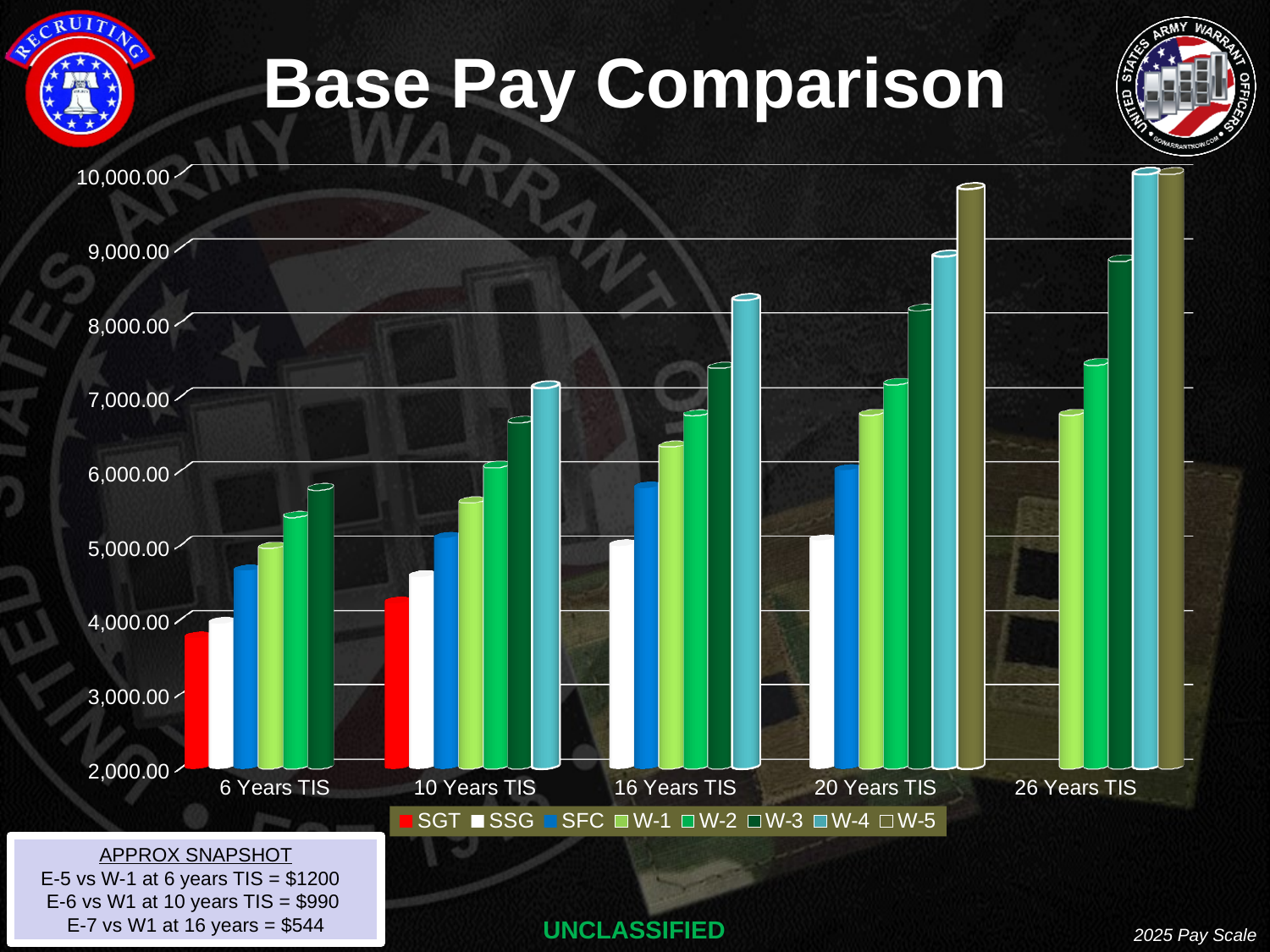
Which series has the lowest value at 6 Years TIS? SGT At 20 Years TIS, which is larger, the value for W-4 or the value for W-3? W-4 How many series does the legend list? 8 Is the value for W-5 at 20 Years TIS greater or less than 9,000.00? greater Is the value for SGT at 6 Years TIS greater or less than 4,000.00? less Is the value for W-3 at 10 Years TIS greater or less than 6,000.00? greater What is the title of the chart? Base Pay Comparison Which series has the highest value at 6 Years TIS? W-3 How many time-in-service categories are shown on the x axis? 5 Do the values for W-4 rise or fall as years of TIS increase along the x axis? rise What kind of chart is shown on the slide? bar chart